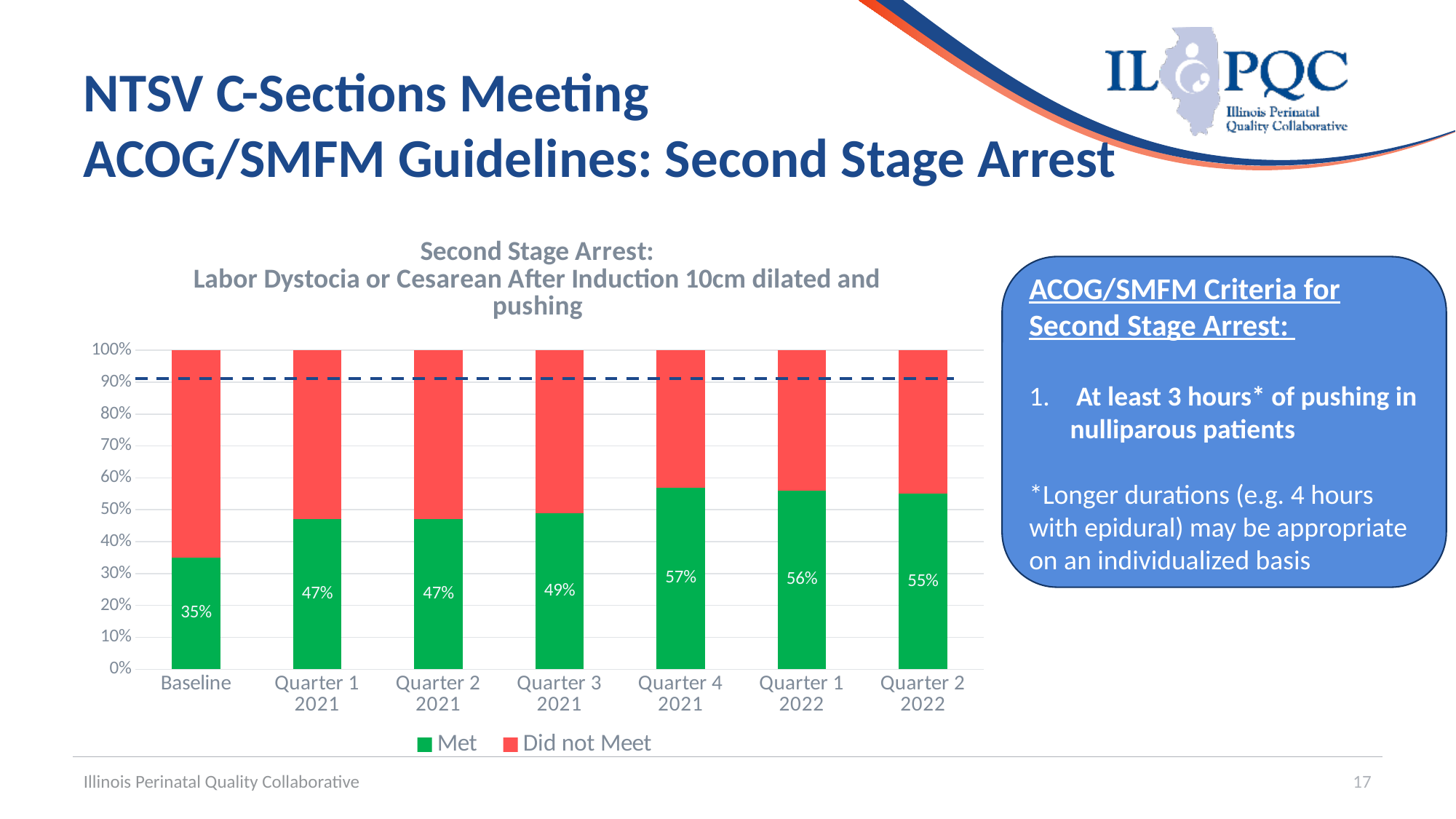
What is the difference between the Met value for Quarter 4 2021 and the Met value for Baseline? 22% What is the Met value for Quarter 4 2021? 57% What type of chart is shown on the slide? Stacked bar chart Which category has the lowest Met value? Baseline At what percentage is the horizontal dashed line drawn on the chart? 90% Which is larger, the Met value for Quarter 3 2021 or the Met value for Quarter 1 2022? Quarter 1 2022 How many categories are shown on the x axis? 7 What is the Met value for Baseline? 35% What is the Met value for Quarter 2 2022? 55% How many series does the legend list? 2 Is the Did not Meet value for Baseline greater or less than 60%? greater Which category has the highest Met value? Quarter 4 2021